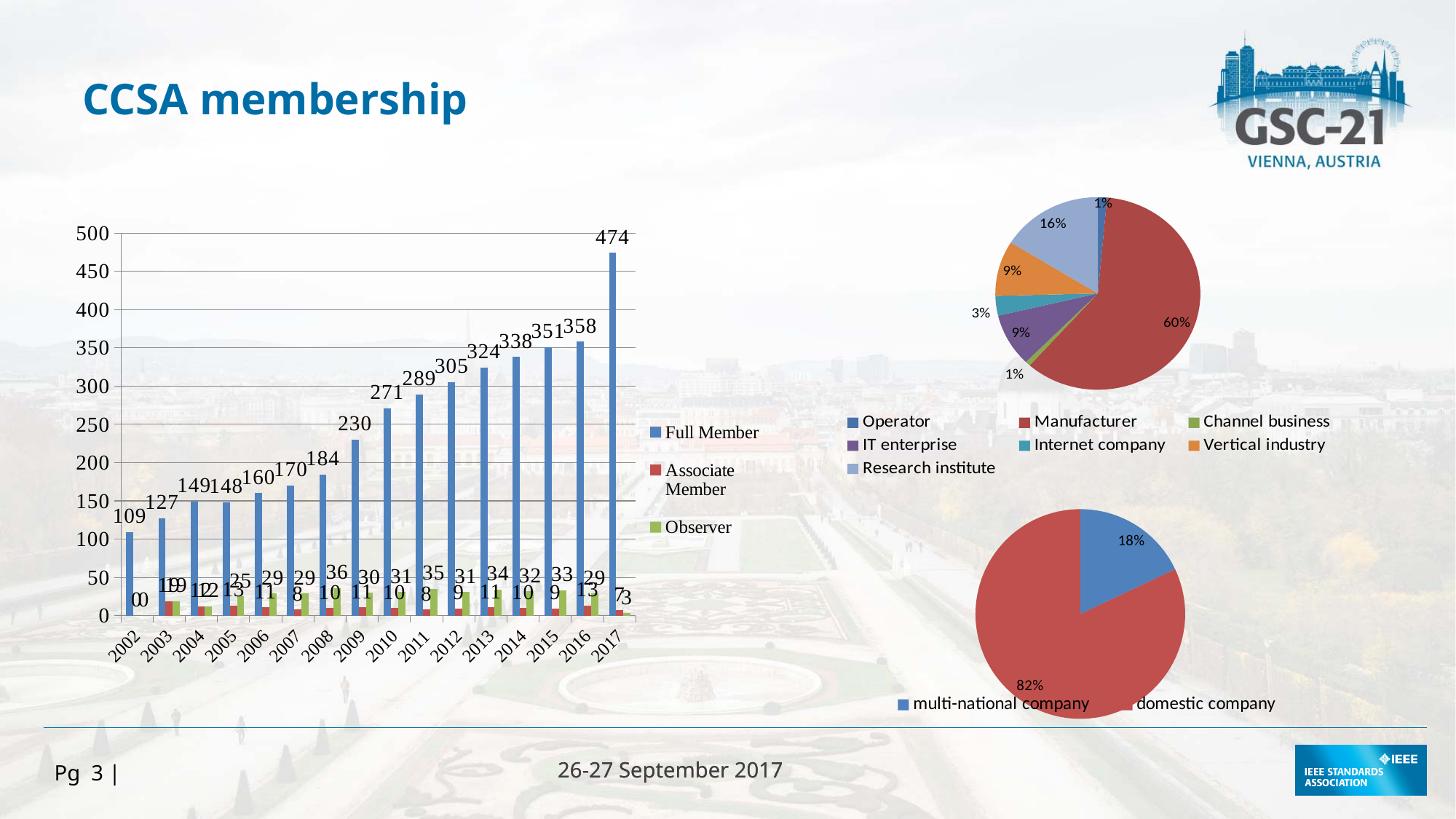
In the bar chart on the left, do the Full Member values generally rise or fall from 2002 to 2017? rise In the bar chart on the left, how many series does the legend list? 3 In the bar chart on the left, which year has the lowest Full Member value? 2002 In the upper-right pie chart, what share does Manufacturer have? 60% In the bar chart on the left, what is the Full Member value for 2017? 474 In the bar chart on the left, how many years are shown on the x axis? 16 In the bar chart on the left, what is the Full Member value for 2009? 230 In the bar chart on the left, which year has the highest Full Member value? 2017 In the lower-right pie chart, what share does domestic company have? 82% In the bar chart on the left, what is the difference between the Full Member values for 2017 and 2016? 116 What kind of chart is the chart on the left of the slide? bar chart In the upper-right pie chart, what share does Research institute have? 16%